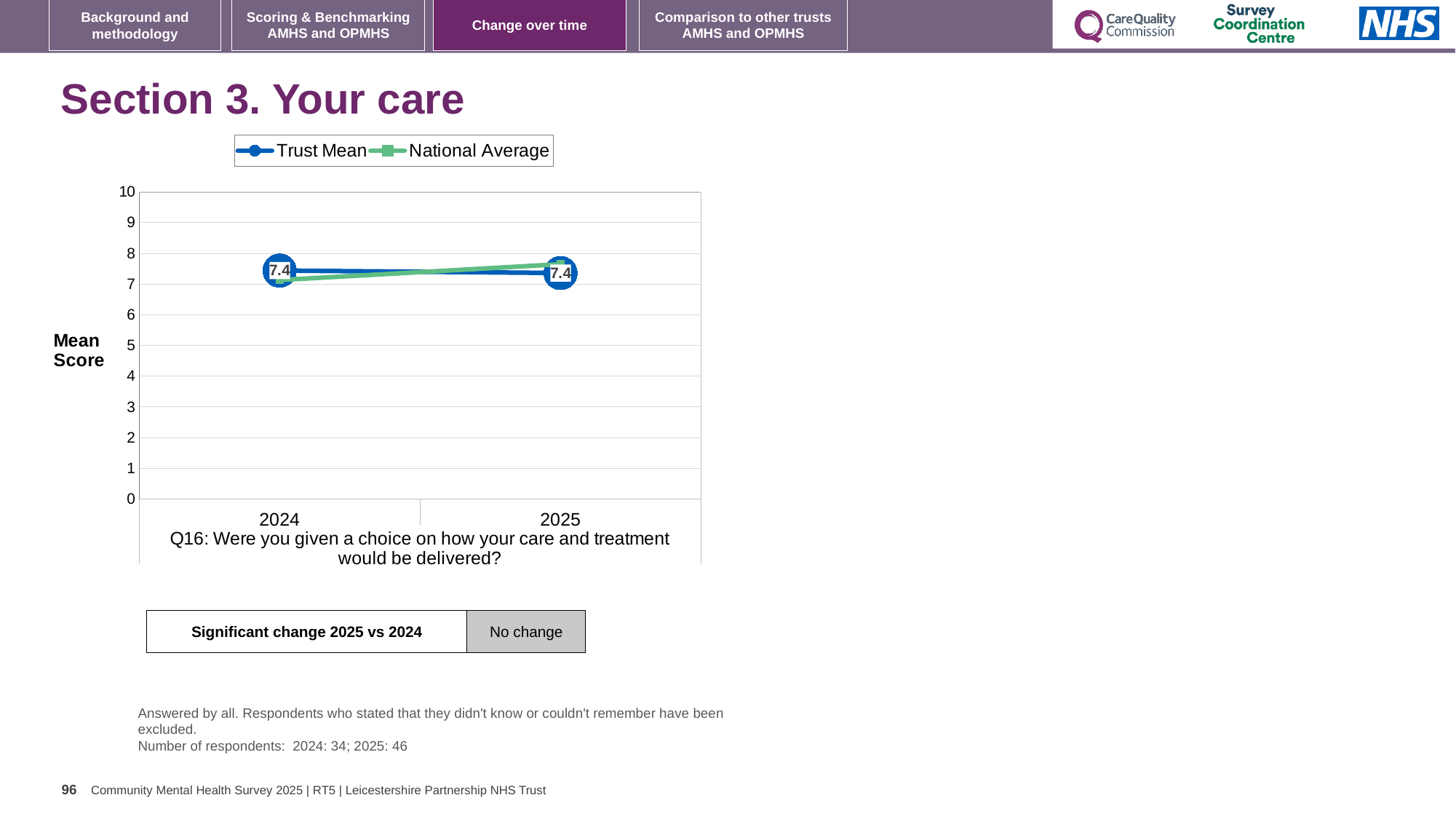
How many series does the chart legend list? 2 What kind of chart is shown on the slide? line chart Is the National Average value for 2025 greater or less than 7? greater How many years are plotted on the x axis of the chart? 2 Is the Trust Mean value for 2024 greater or less than 5? greater What is the Trust Mean score for 2025? 7.4 What is the Trust Mean score for 2024? 7.4 What is the difference between the Trust Mean scores for 2025 and 2024? 0 Is the National Average value for 2025 greater or less than 8? less Which series in the legend is shown in green? National Average What is the label of the y axis of the chart? Mean Score Does the Trust Mean rise, fall or stay the same from 2024 to 2025? stays the same